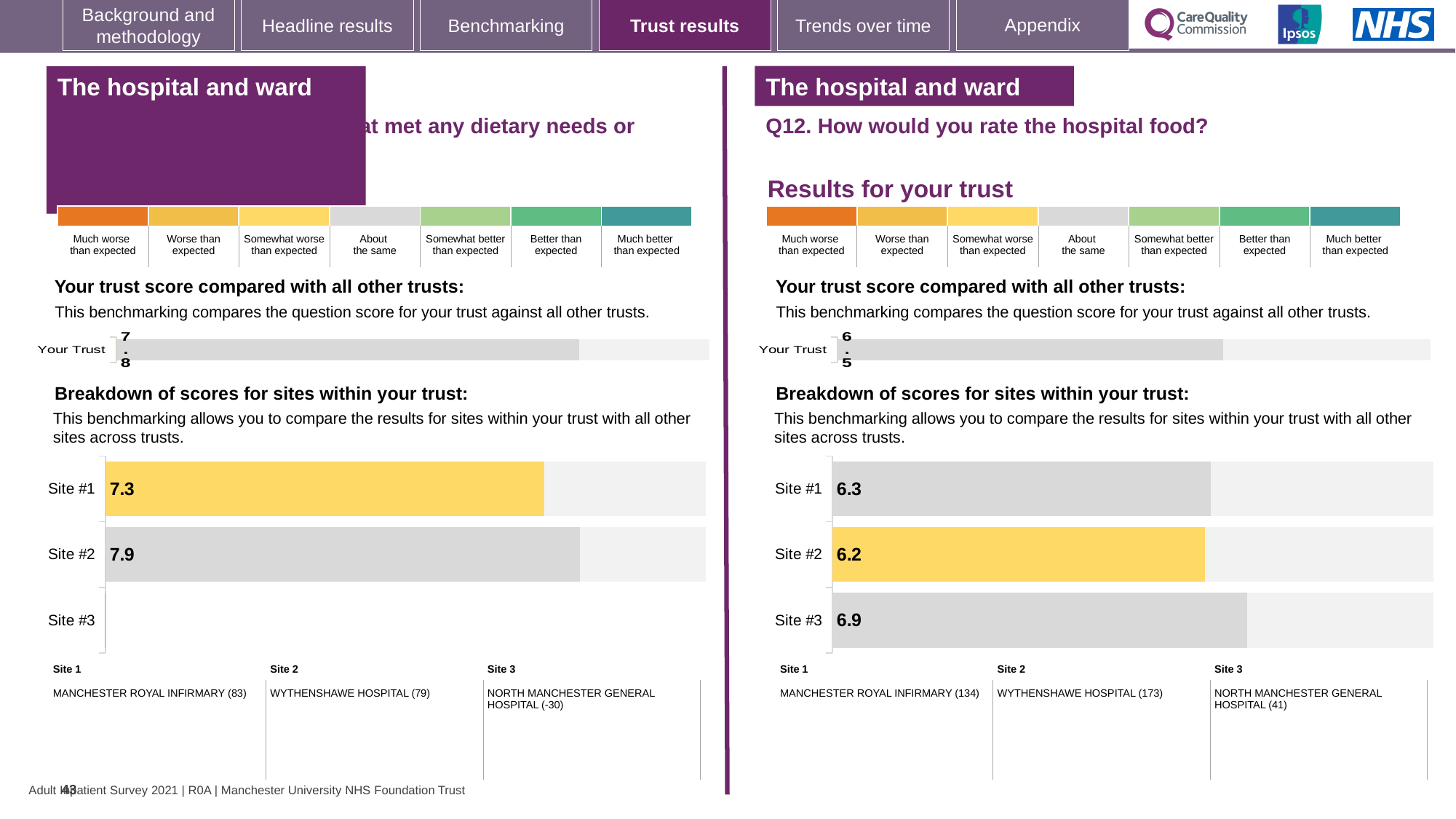
What type of chart is used for the breakdown of scores for sites on the right-hand side? Bar chart On the right-hand chart (Q12, hospital food), what is the score for Site #1? 6.3 On the right-hand chart (Q12, hospital food), what is the score for Site #3? 6.9 On the right-hand chart (Q12, hospital food), which site has the highest score? Site #3 On the right-hand chart (Q12, hospital food), which site has the lowest score? Site #2 On the right-hand chart (Q12, hospital food), what is the difference between the Site #3 and Site #2 scores? 0.7 On the right-hand chart (Q12, hospital food), what is the 'Your Trust' score? 6.5 On the left-hand chart, what is the difference between the Site #2 and Site #1 scores? 0.6 On the left-hand chart, what is the 'Your Trust' score? 7.8 On the left-hand chart, what is the score for Site #2? 7.9 On the left-hand chart, which has the higher score, Site #1 or Site #2? Site #2 On the right-hand chart (Q12, hospital food), how many sites are listed in the site breakdown? 3